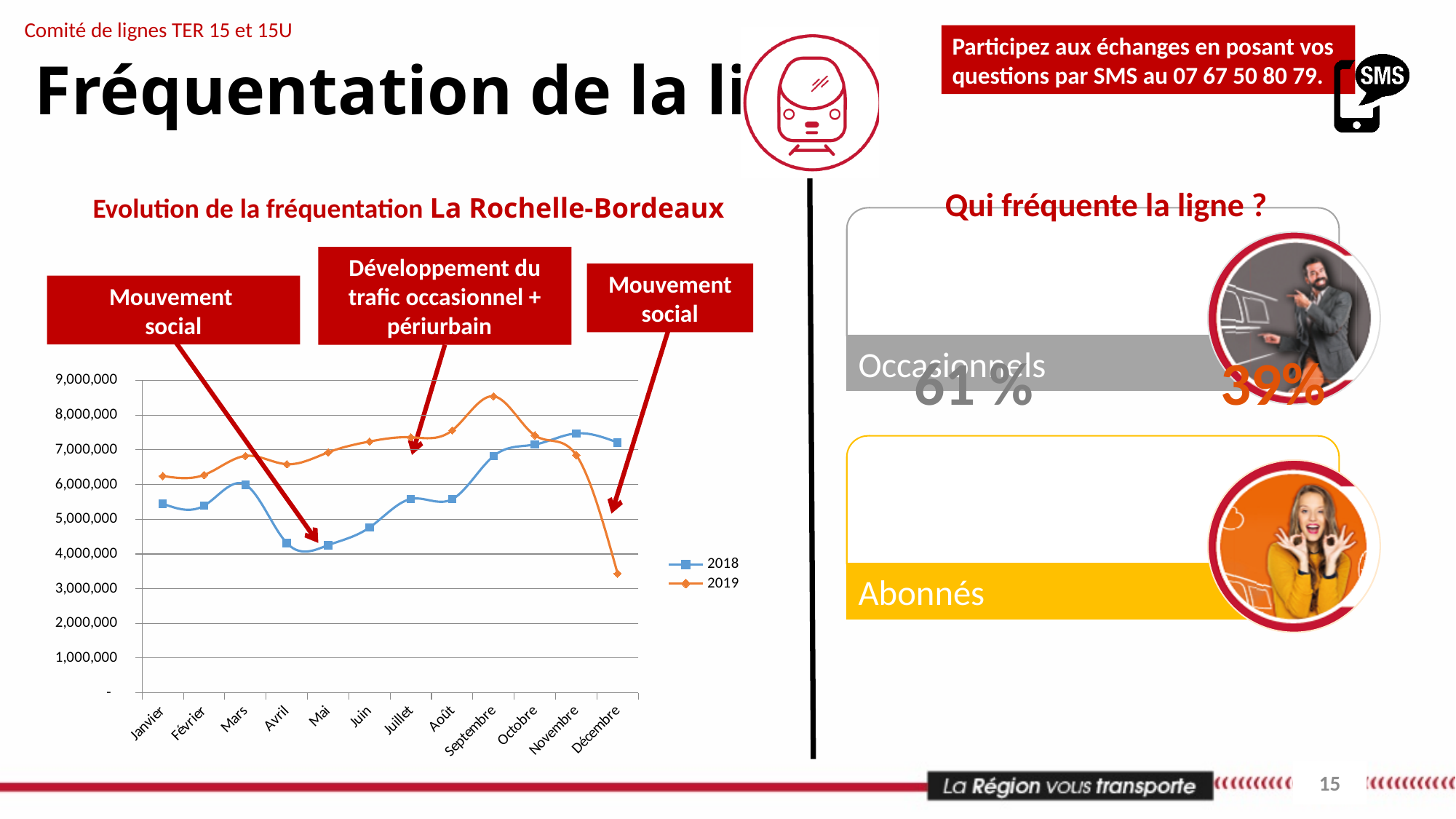
Which series is drawn in orange in the line chart? 2019 What kind of chart is 'Evolution de la fréquentation La Rochelle-Bordeaux'? Line chart How many months are shown on the x axis of the line chart? 12 Is the 2019 value for Décembre greater or less than 4,000,000? less In the line chart, which month has the lowest value for 2019? Décembre Is the 2018 value for Mai greater or less than 5,000,000? less How many series does the legend of the line chart list? 2 In Janvier, which series has the larger value, 2018 or 2019? 2019 In the line chart, which month has the highest value for 2018? Novembre In Décembre, which series has the larger value, 2018 or 2019? 2018 In the line chart, which month has the highest value for 2019? Septembre Is the 2019 value for Septembre greater or less than 8,000,000? greater